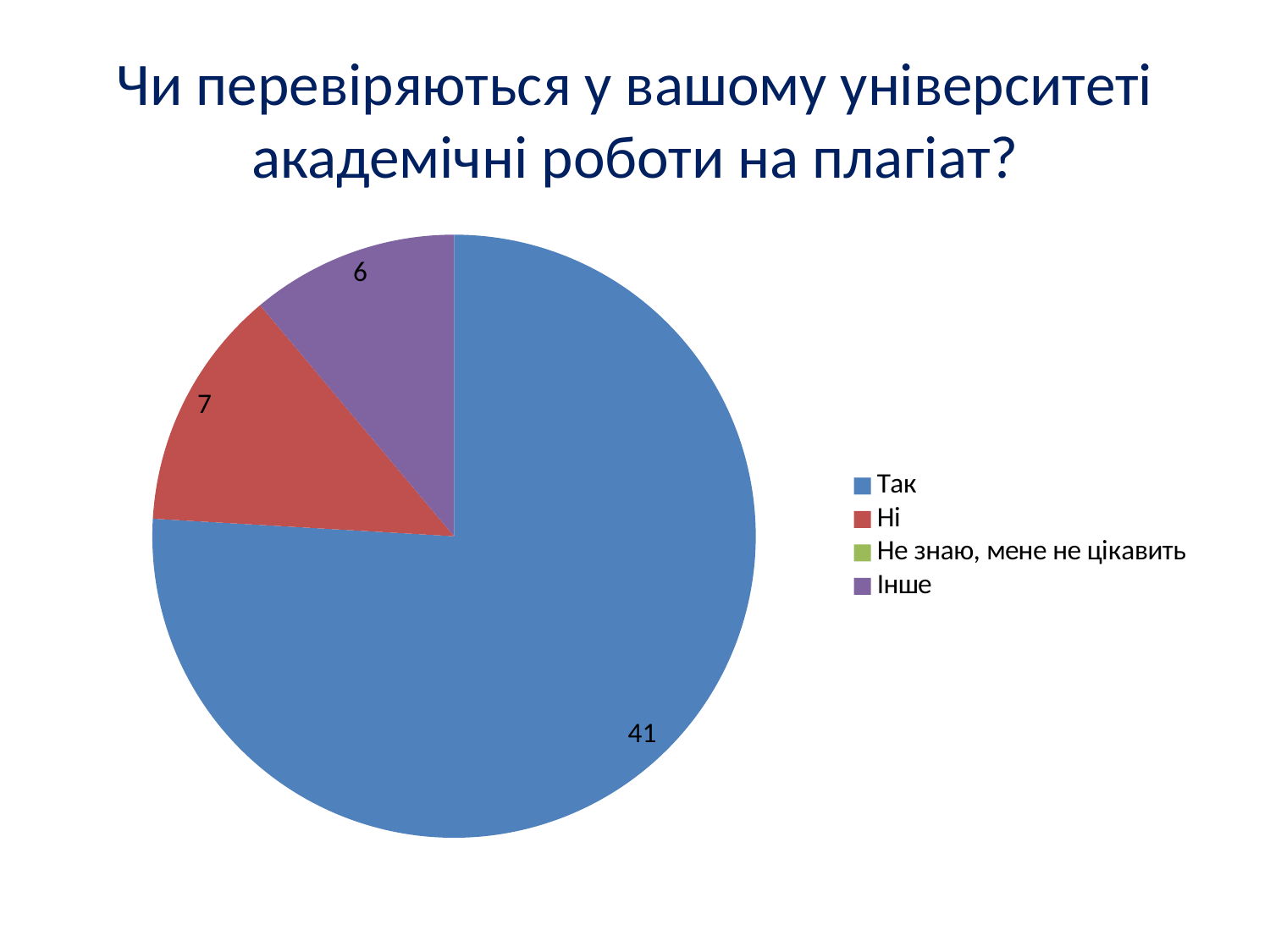
What kind of chart is shown on the slide? Pie chart What is the title of the chart? Чи перевіряються у вашому університеті академічні роботи на плагіат? What is the value for the "Так" slice? 41 What is the difference between the values for "Так" and "Ні"? 34 Which is larger, the value for "Так" or the value for "Інше"? Так What colour is the "Так" slice? Blue How many entries does the legend list? 4 What is the value for the "Ні" slice? 7 What is the difference between the values for "Ні" and "Інше"? 1 Which category has the largest slice of the pie? Так What is the value for the "Інше" slice? 6